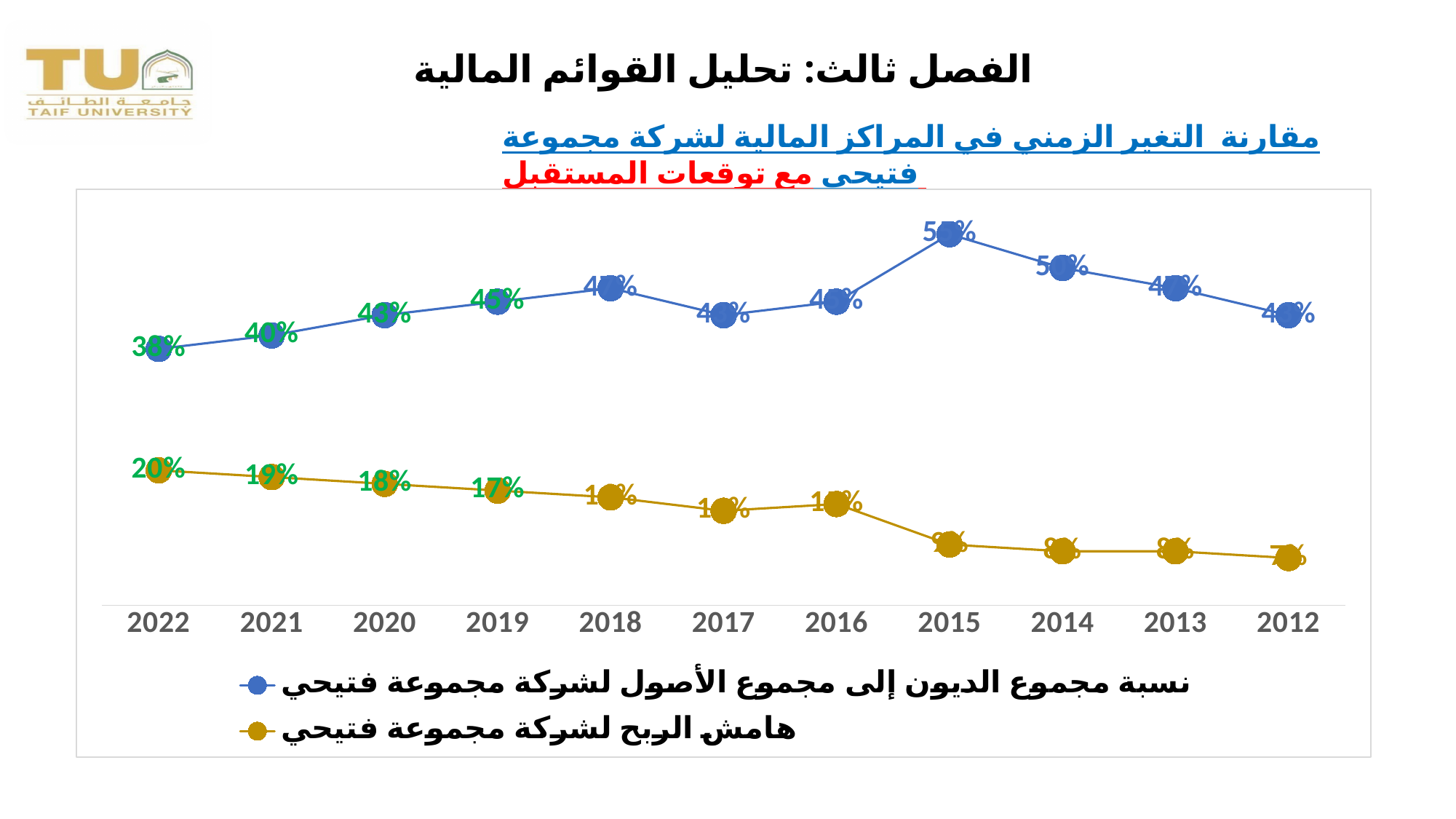
In which year is the blue series (نسبة مجموع الديون إلى مجموع الأصول) at its highest? 2015 What kind of chart is shown on the slide? line chart For 2021, which series has the larger value, the blue series or the gold series? the blue series (نسبة مجموع الديون إلى مجموع الأصول) In which year is the gold series (هامش الربح) at its lowest? 2012 How many series does the legend list? 2 What is the difference between the gold series (هامش الربح) values for 2022 and 2019? 3 percentage points Does the gold series (هامش الربح) generally rise or fall moving from 2022 on the left to 2012 on the right? fall What is the value of the blue series (نسبة مجموع الديون إلى مجموع الأصول) for 2020? 43% What is the value of the gold series (هامش الربح) for 2019? 17% What is the value of the blue series (نسبة مجموع الديون إلى مجموع الأصول) for 2022? 38% How many years are shown on the x axis? 11 What is the value of the gold series (هامش الربح) for 2022? 20%